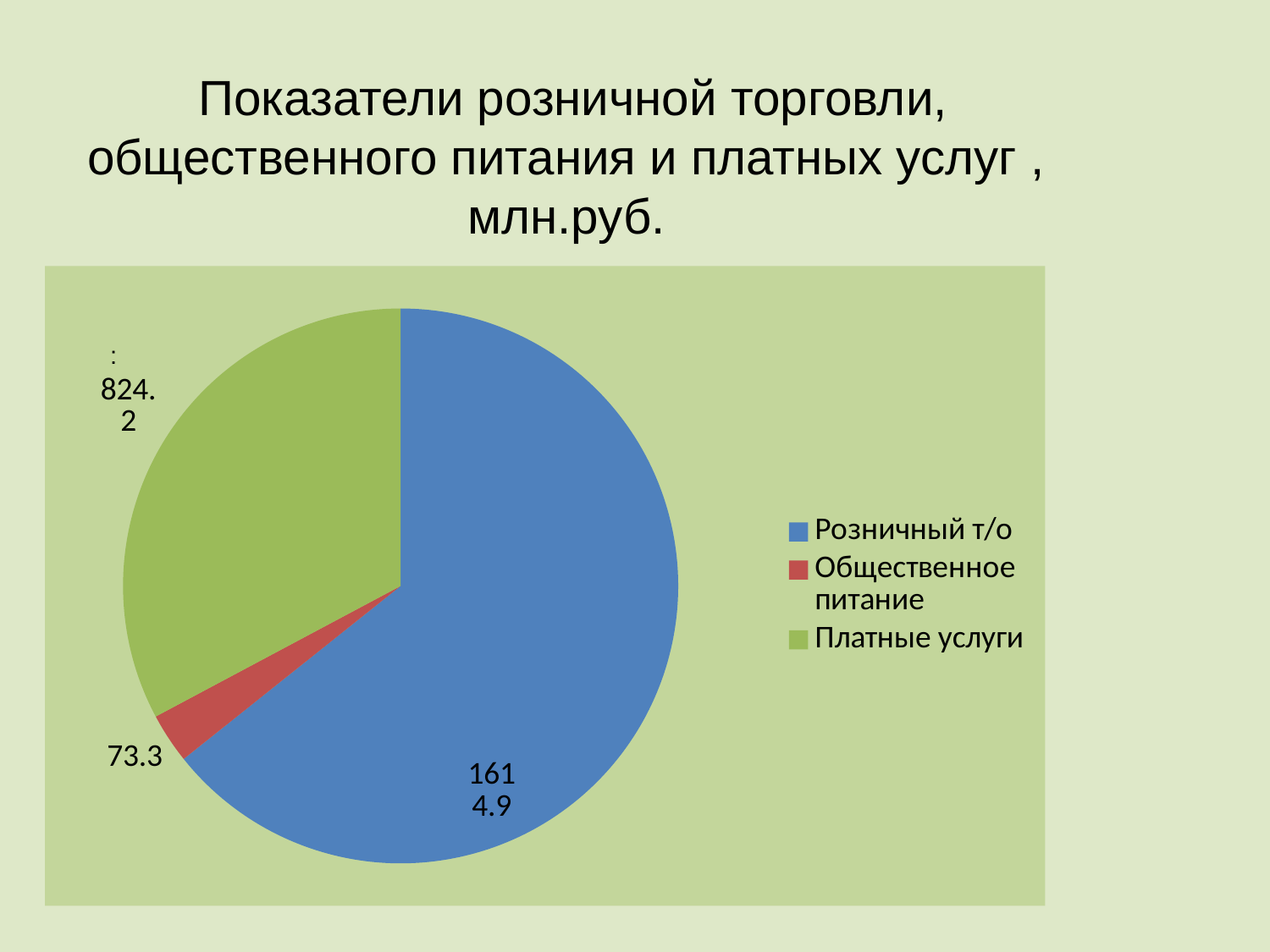
Which category has the largest slice of the pie? Розничный т/о Which is larger, Платные услуги or Общественное питание? Платные услуги How many entries does the legend list? 3 What is the value for Розничный т/о? 1614.9 What is the difference between the values for Платные услуги and Общественное питание? 750.9 What kind of chart is shown on the slide? pie chart How many slices does the pie chart have? 3 What colour is the slice for Платные услуги? green What is the value for Платные услуги? 824.2 What is the value for Общественное питание? 73.3 What unit is stated in the chart title? млн.руб. Which category has the smallest slice of the pie? Общественное питание